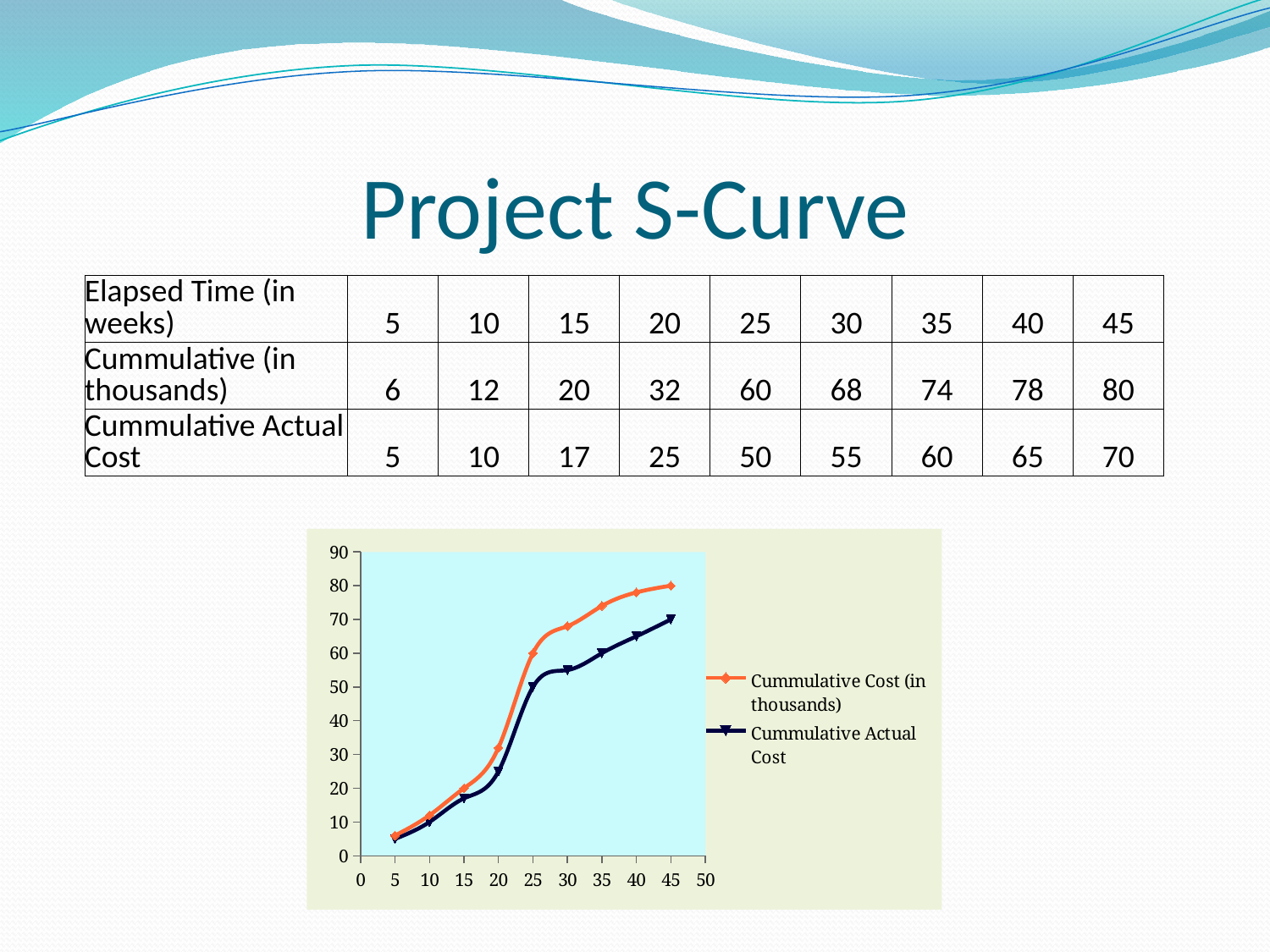
What is the Cummulative Actual Cost at 45 weeks? 70 What kind of chart is shown on the slide? line chart At which elapsed time is the Cummulative Cost (in thousands) lowest? 5 At 30 weeks, which is larger: the Cummulative Cost (in thousands) or the Cummulative Actual Cost? Cummulative Cost (in thousands) At which elapsed time is the Cummulative Actual Cost highest? 45 Do the values of the Cummulative Actual Cost series rise or fall as elapsed time increases? rise How many series does the chart legend list? 2 Which series is drawn in orange in the chart? Cummulative Cost (in thousands) What is the Cummulative Cost (in thousands) at 20 weeks? 32 What is the Cummulative Cost (in thousands) at 25 weeks? 60 What is the difference between the Cummulative Cost (in thousands) and the Cummulative Actual Cost at 45 weeks? 10 How many data points does each series have in the chart? 9